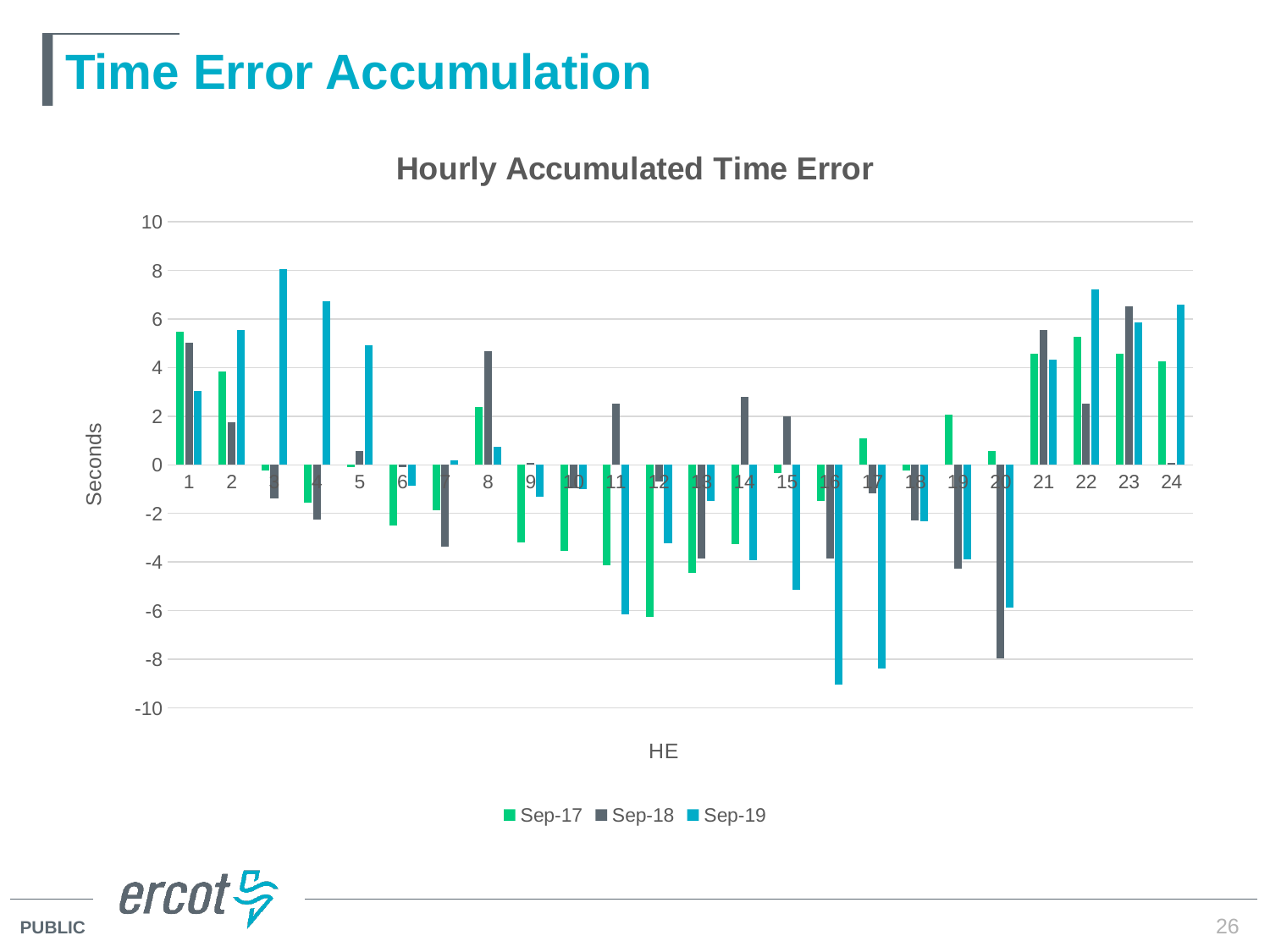
Is the Sep-19 value at HE 3 greater or less than 6? greater What is the title of the chart? Hourly Accumulated Time Error Is the Sep-17 value at HE 1 greater or less than 4? greater At which HE does the Sep-19 series reach its highest value? 3 What is the label on the vertical axis? Seconds How many series does the legend list? 3 Is the Sep-17 value at HE 12 greater or less than -4? less At HE 1, which series has the larger value, Sep-17 or Sep-19? Sep-17 What kind of chart is shown on the slide? bar chart How many hour-ending (HE) categories are shown on the x axis? 24